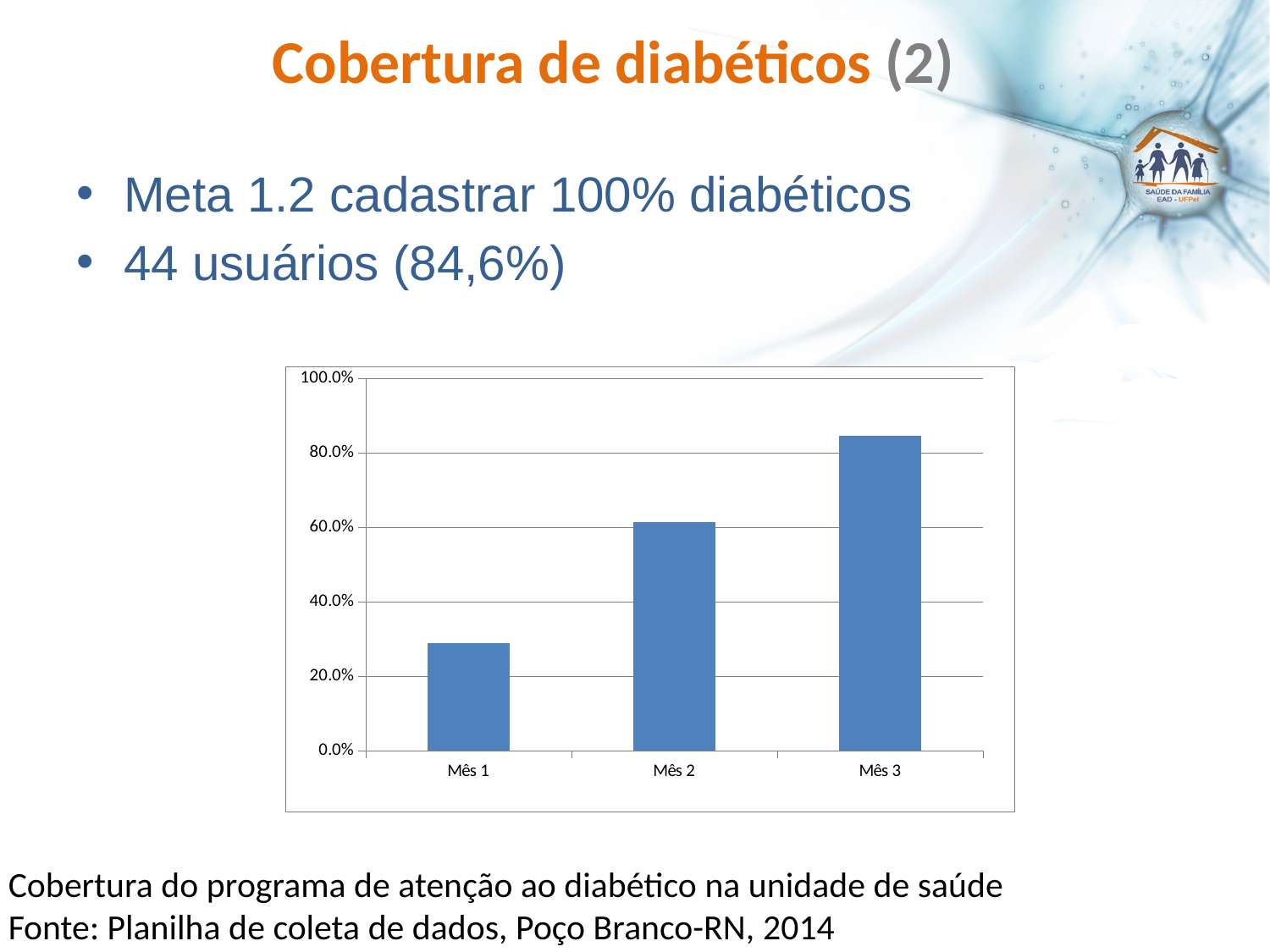
Do the values rise or fall from Mês 1 to Mês 3? rise Is the value for Mês 1 greater or less than 20.0%? greater Which is larger, the value for Mês 2 or the value for Mês 3? Mês 3 Is the value for Mês 1 greater or less than 40.0%? less Is the value for Mês 2 greater or less than 60.0%? greater Which month has the highest bar in the chart? Mês 3 How many categories are shown on the x axis of the chart? 3 What is the maximum value shown on the y axis of the chart? 100.0% What kind of chart is shown on the slide? bar chart Which month has the lowest bar in the chart? Mês 1 What colour are the bars in the chart? blue